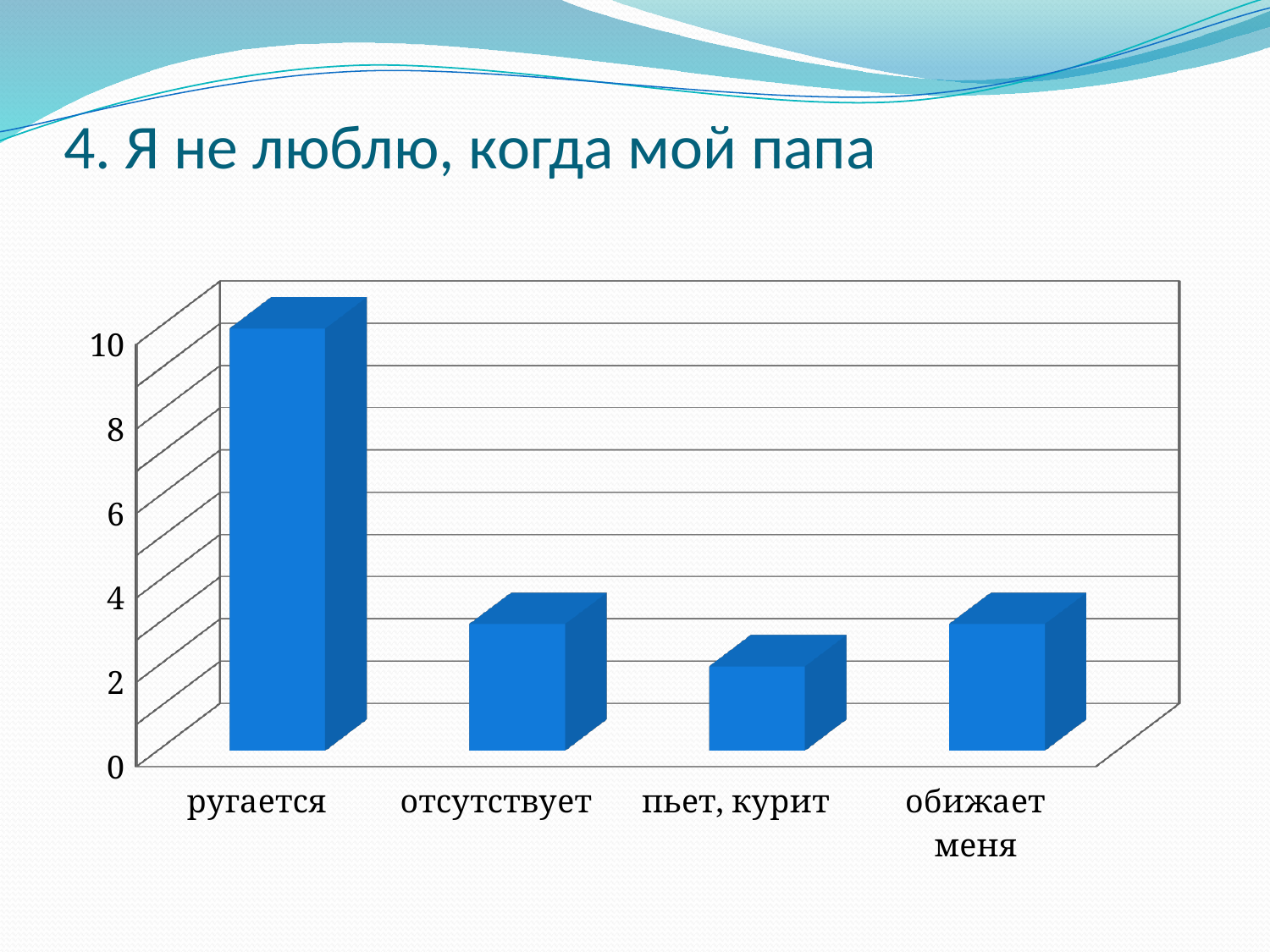
Which is larger, the value for обижает меня or the value for пьет, курит? обижает меня Is the value for обижает меня greater or less than 6? less Is the value for ругается greater or less than 8? greater What is the highest tick value shown on the vertical axis of the chart? 10 Is the value for отсутствует greater or less than 4? less Which category has the highest bar in the chart? ругается What is the title of the slide above the chart? 4. Я не люблю, когда мой папа Which category has the lowest bar in the chart? пьет, курит What kind of chart is shown on the slide? bar chart How many categories are shown on the x axis of the chart? 4 Which is larger, the value for ругается or the value for отсутствует? ругается